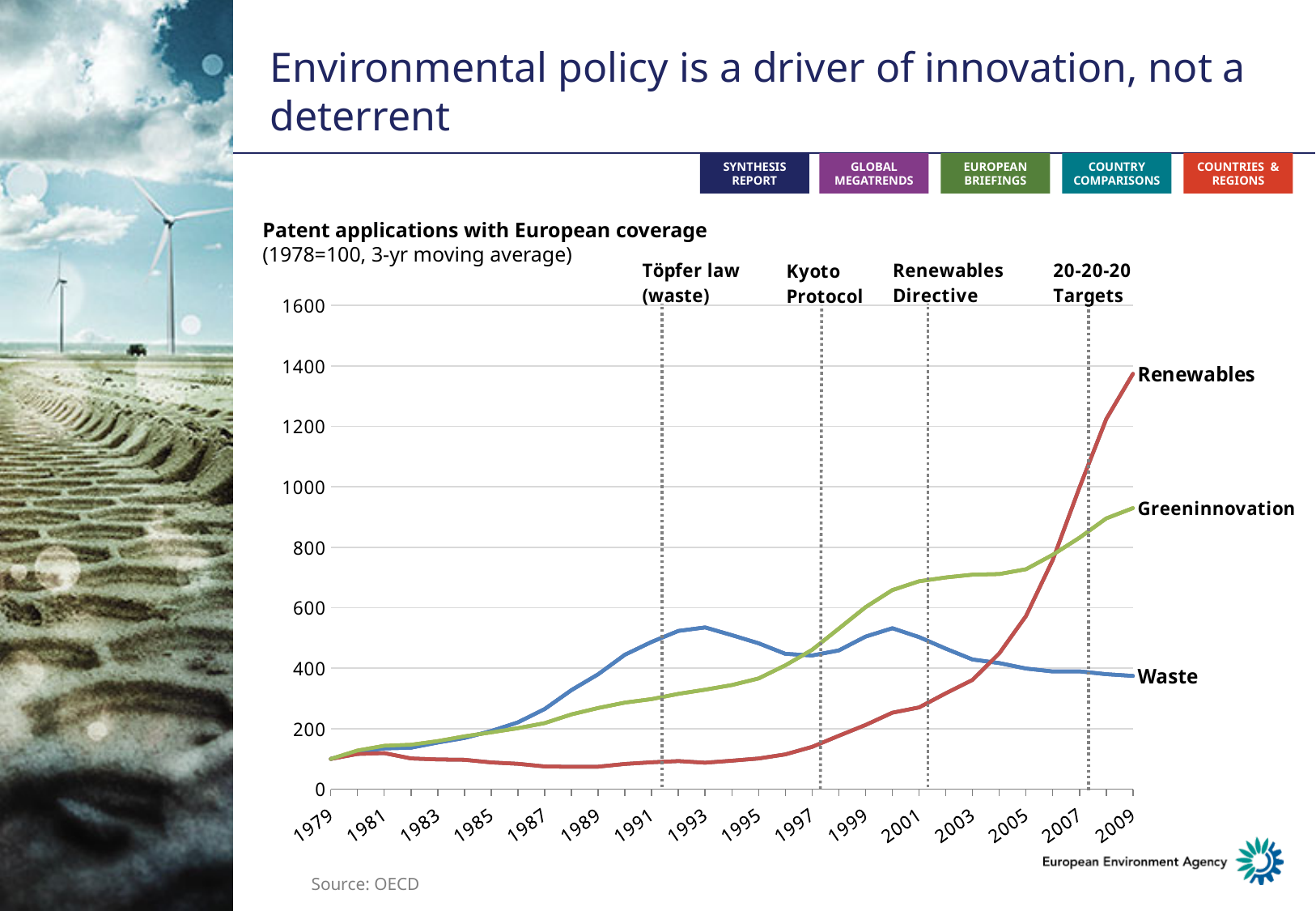
Which series has the highest value in 2009? Renewables Is the value for Greeninnovation in 2009 greater or less than 1000? less How many policy events are marked with vertical dashed lines on the chart? 4 Is the value for Waste in 2009 greater or less than 400? less Is the value for Renewables in 2009 greater or less than 1200? greater What kind of chart is shown on the slide? line chart Does the Renewables series rise or fall between 2001 and 2009? rise In 1993, which series is larger, Waste or Renewables? Waste Which series has the lowest value in 2009? Waste How many series are plotted on the chart? 3 What is the title of the chart? Patent applications with European coverage